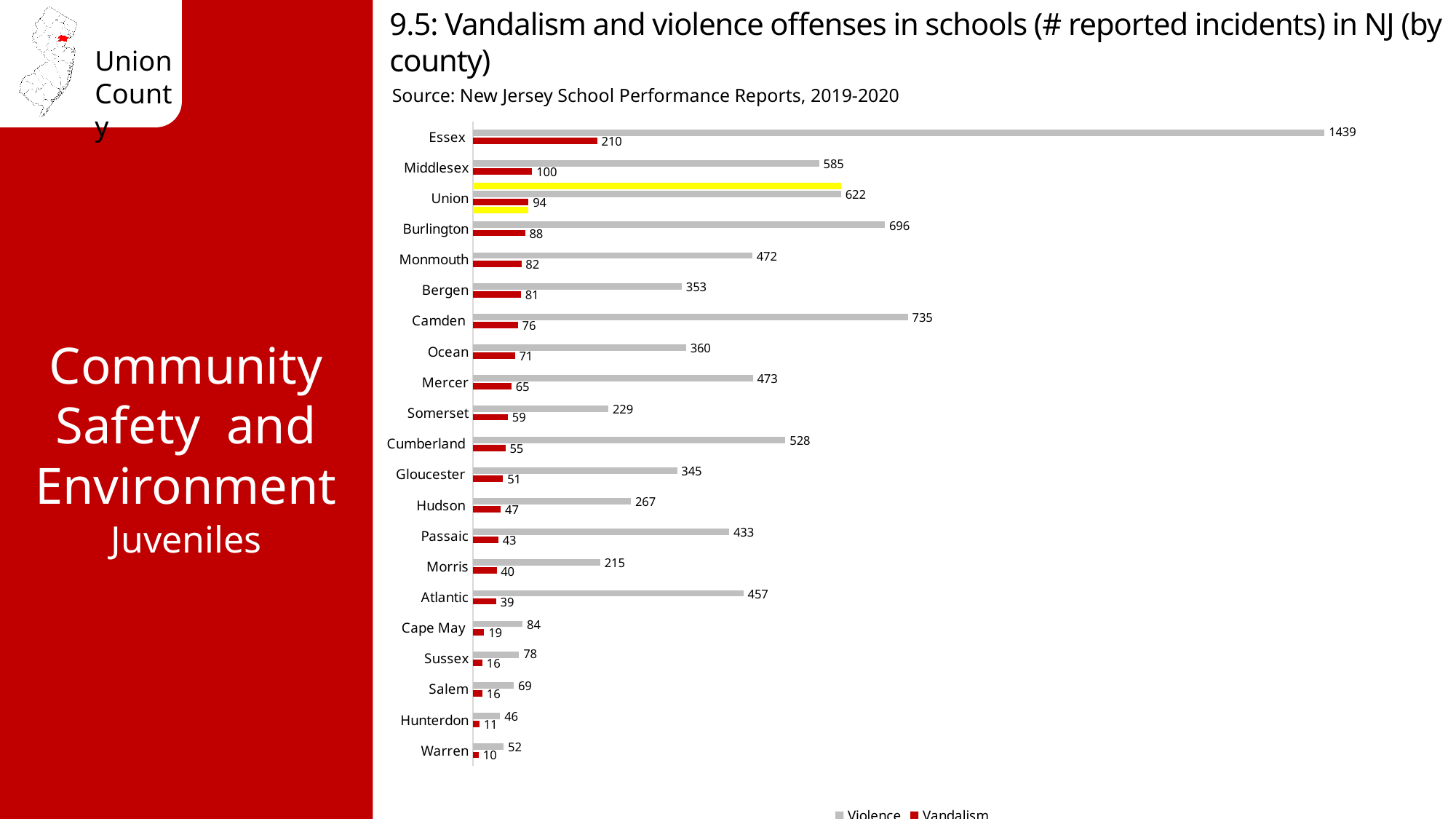
Which county has more Violence incidents, Middlesex or Union? Union Which county has the lowest number of Vandalism incidents? Warren What is the Vandalism value for Hunterdon county? 11 What is the combined total of Violence and Vandalism incidents for Union county? 716 What is the number of reported Vandalism incidents for Camden county? 76 Which county has the highest number of Violence incidents? Essex How many counties are shown in the chart? 21 What kind of chart is shown on the slide? Bar chart What is the number of reported Violence incidents for Union county? 622 What is the difference between the Violence values for Essex and Camden? 704 How many series does the legend list? 2 Which county has the lowest number of Violence incidents? Hunterdon